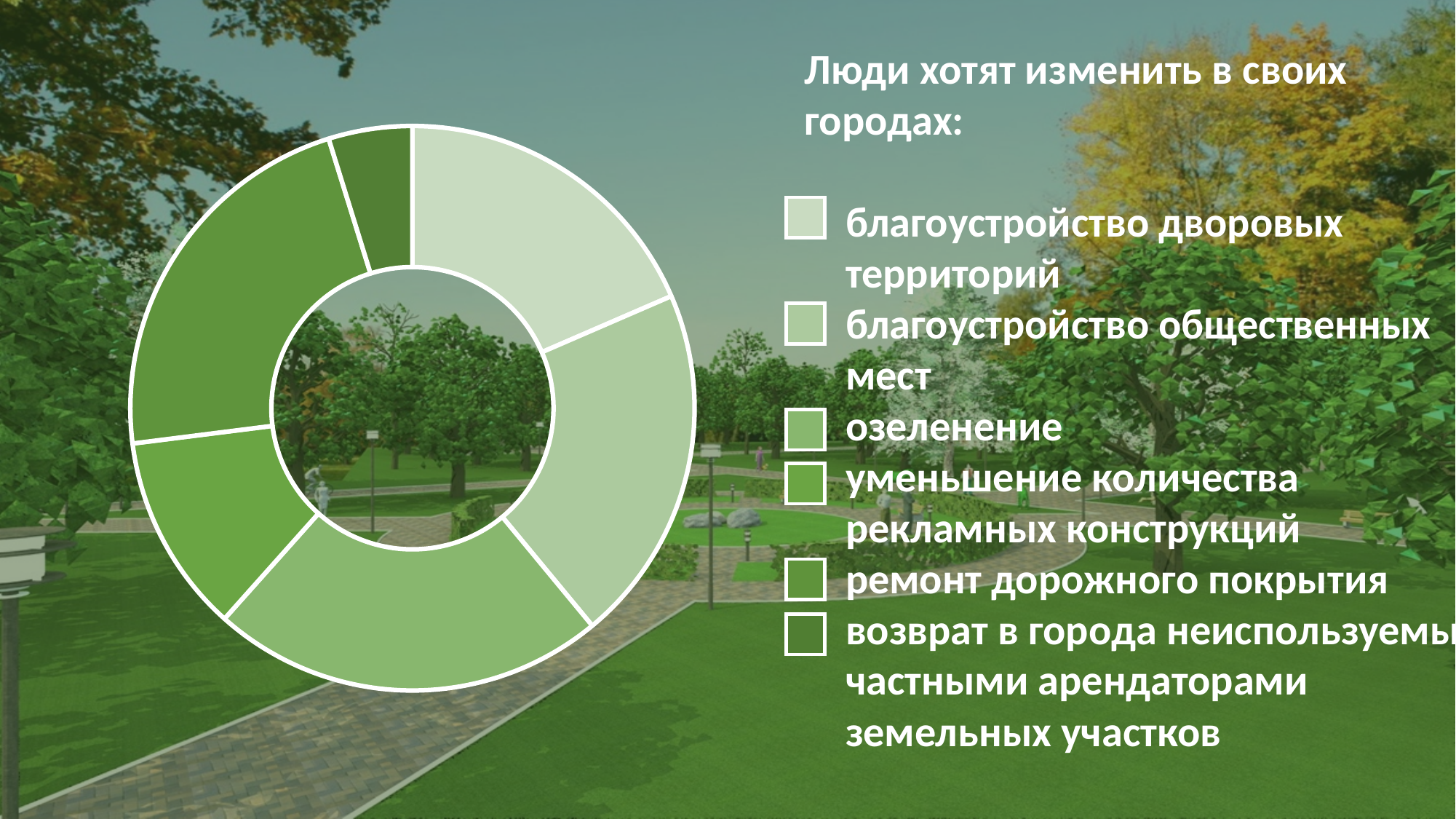
Which category has the smallest slice in the chart? возврат в города неиспользуемых частными арендаторами земельных участков Which legend entry is shown with the lightest green colour? благоустройство дворовых территорий How many entries does the legend list? 6 How many slices does the donut chart have? 6 Which slice is larger: 'ремонт дорожного покрытия' or 'возврат в города неиспользуемых частными арендаторами земельных участков'? ремонт дорожного покрытия Which slice is larger: 'благоустройство общественных мест' or 'уменьшение количества рекламных конструкций'? благоустройство общественных мест Which slice is larger: 'озеленение' or 'уменьшение количества рекламных конструкций'? озеленение What is the title text above the legend of the chart? Люди хотят изменить в своих городах: What kind of chart is shown on the slide? Donut (pie) chart